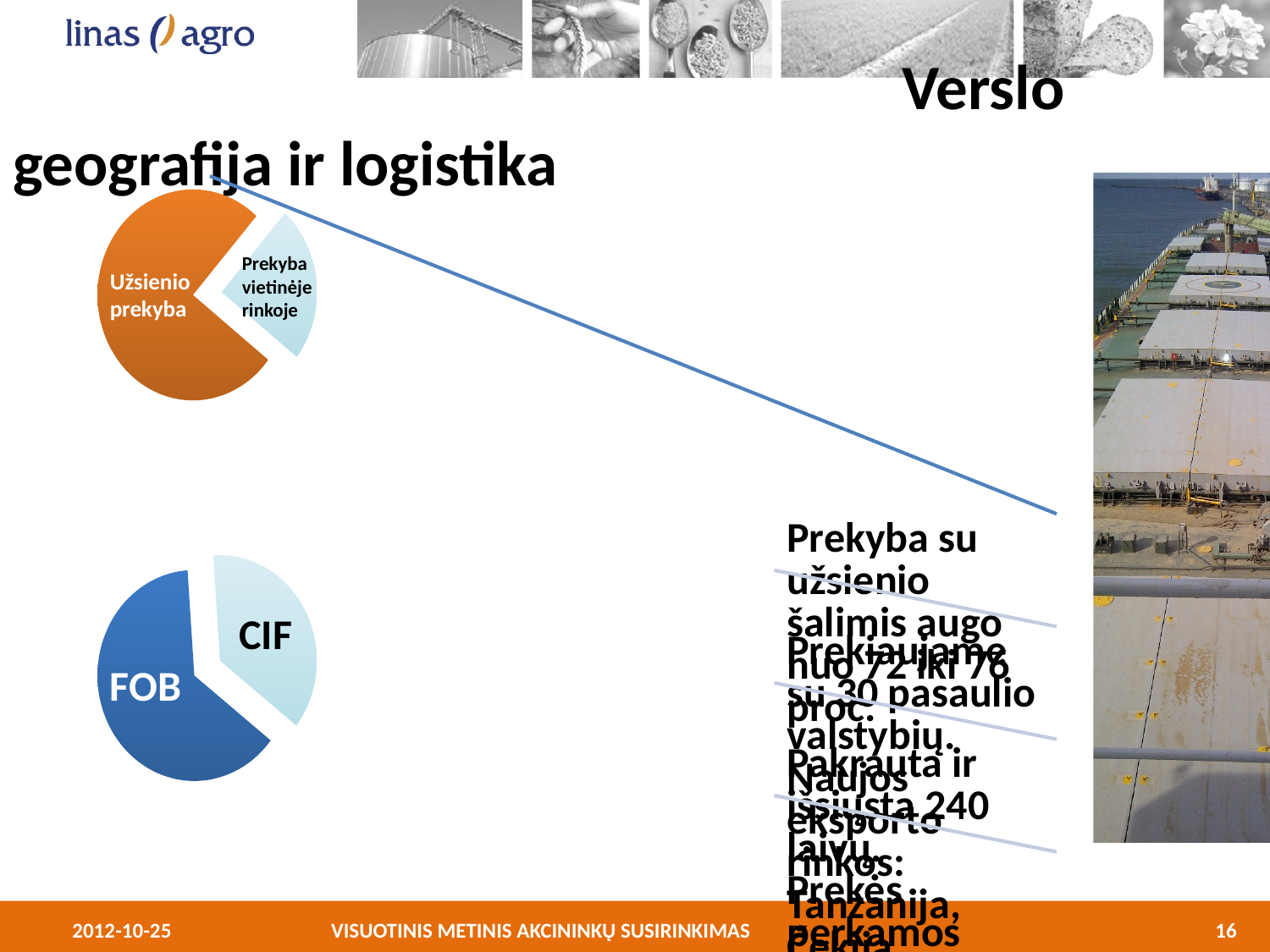
In the top pie chart, which slice is the largest? Užsienio prekyba In the bottom pie chart, how many slices are there? 2 In the top pie chart, which slice is the smallest? Prekyba vietinėje rinkoje In the top pie chart, what colour is the Užsienio prekyba slice? orange In the bottom pie chart, which slice is the smallest? CIF In the bottom pie chart, what colour is the FOB slice? blue In the top pie chart, how many slices are there? 2 In the bottom pie chart, which slice is the largest? FOB In the top pie chart, which is larger, Užsienio prekyba or Prekyba vietinėje rinkoje? Užsienio prekyba What kind of chart is the top chart on the slide? pie chart What kind of chart is the bottom chart on the slide? pie chart In the bottom pie chart, which is larger, FOB or CIF? FOB